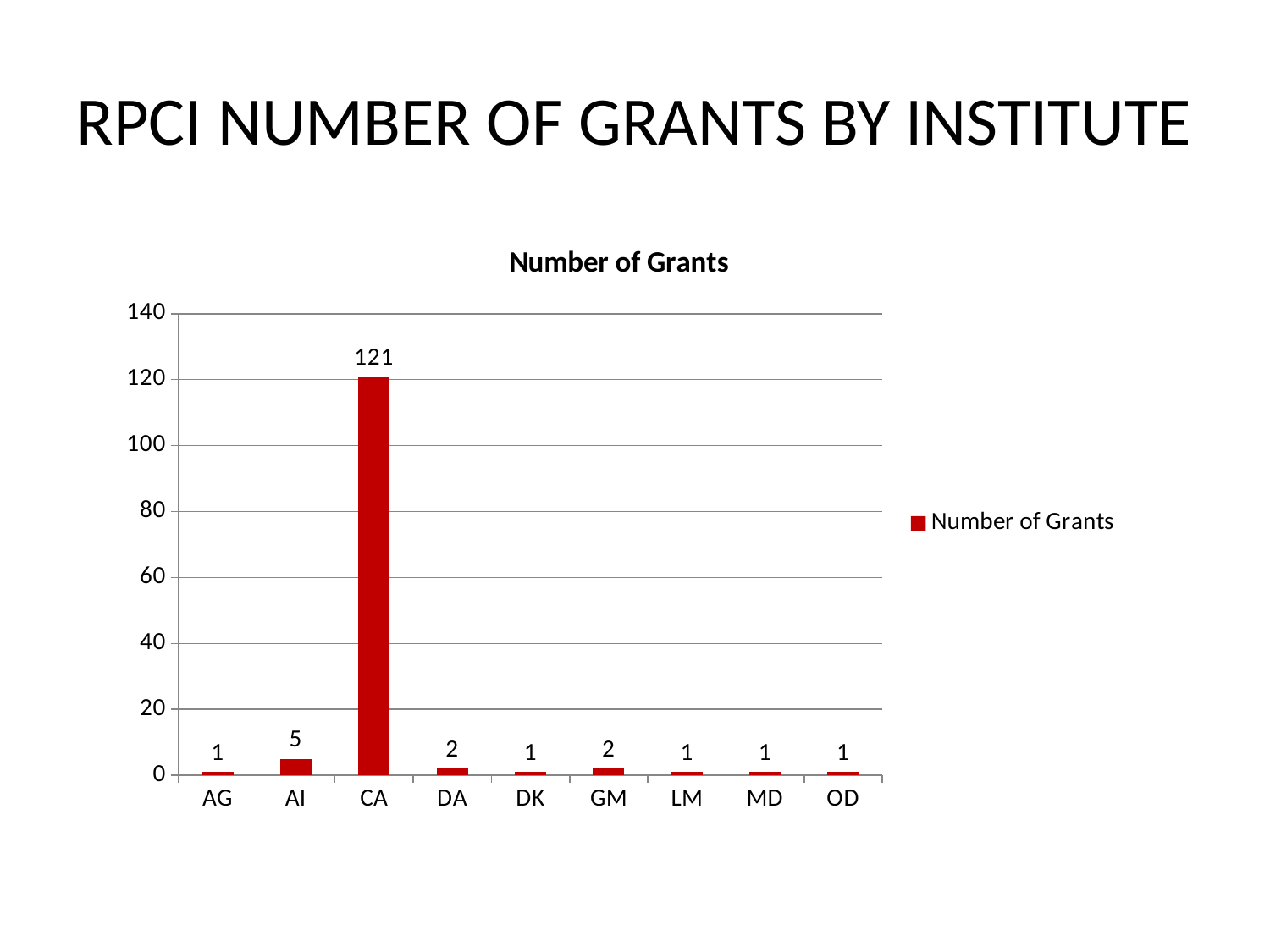
What is the number of grants for AI? 5 Which has more grants, AI or DA? AI Is the number of grants for CA greater or less than 100? greater What is the title of the chart? Number of Grants How many series does the legend list? 1 What kind of chart is shown on the slide? bar chart What is the difference in number of grants between CA and AI? 116 What is the number of grants for CA? 121 Which institute has the highest number of grants? CA What is the difference in number of grants between AI and GM? 3 What is the number of grants for DA? 2 How many institutes are shown on the x axis? 9